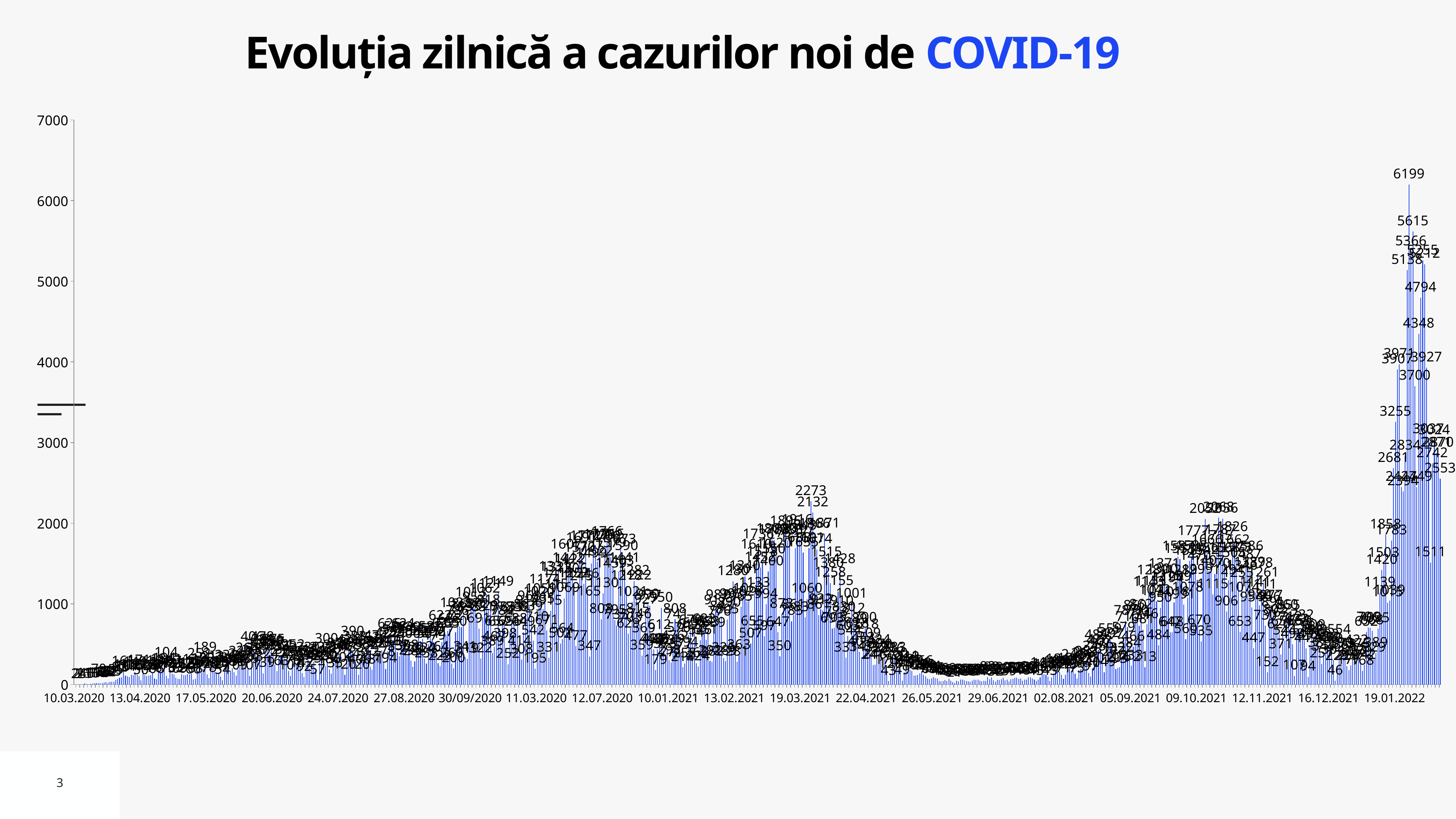
Is the highest bar on the chart greater or less than 6000? greater What kind of chart is shown on the slide? bar chart Are the values around 29.06.2021 greater or less than 1000? less Is the peak value near 19.03.2021 greater or less than 2000? greater What is the first date shown on the horizontal axis? 10.03.2020 What is the difference between the two highest labelled values, 6199 and 5615? 584 What is the last date shown on the horizontal axis? 19.01.2022 What is the title of the chart? Evoluția zilnică a cazurilor noi de COVID-19 What is the highest value labelled on the chart? 6199 What is the highest tick value shown on the vertical axis? 7000 Which is larger: the peak value labelled 2273 near 19.03.2021 or the peak value labelled 6199 near 19.01.2022? 6199